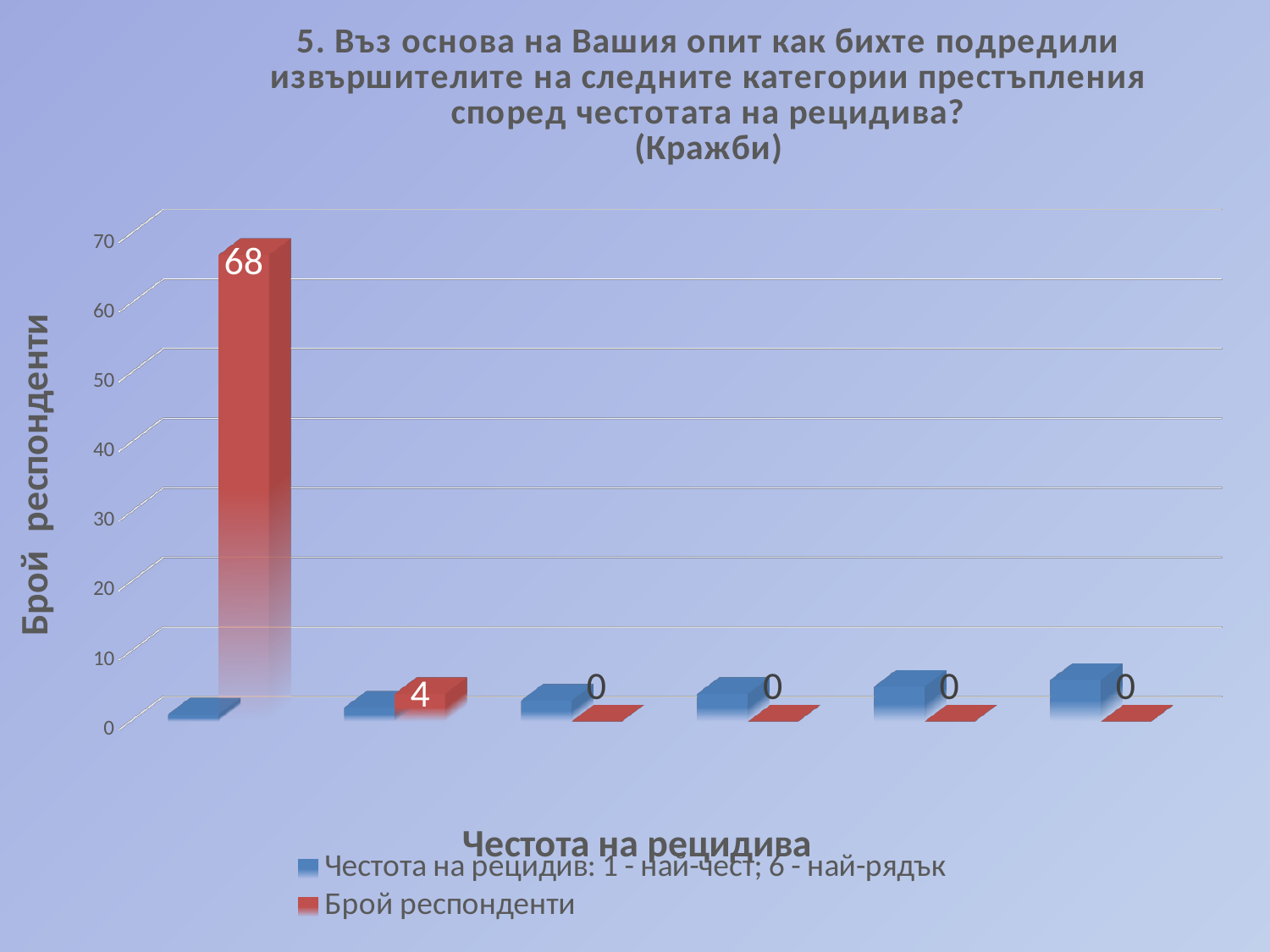
What is the value of the 'Брой респонденти' bar in the last (rightmost) group? 0 How many groups of bars are plotted along the x axis? 6 What is the difference between the 'Брой респонденти' values of the first and second groups? 64 Is the 'Брой респонденти' value in the first group greater or less than 60? greater What is the value of the 'Брой респонденти' bar in the second group from the left? 4 What is the value of the 'Брой респонденти' bar in the first (leftmost) group? 68 Which group has the highest 'Брой респонденти' value? the first (leftmost) group Which is larger: the 'Брой респонденти' value in the first group or in the second group? the first group What type of chart is shown on the slide? bar chart How many series does the legend list? 2 Do the 'Брой респонденти' values rise or fall from left to right along the x axis? fall What is the label of the vertical axis? Брой респонденти